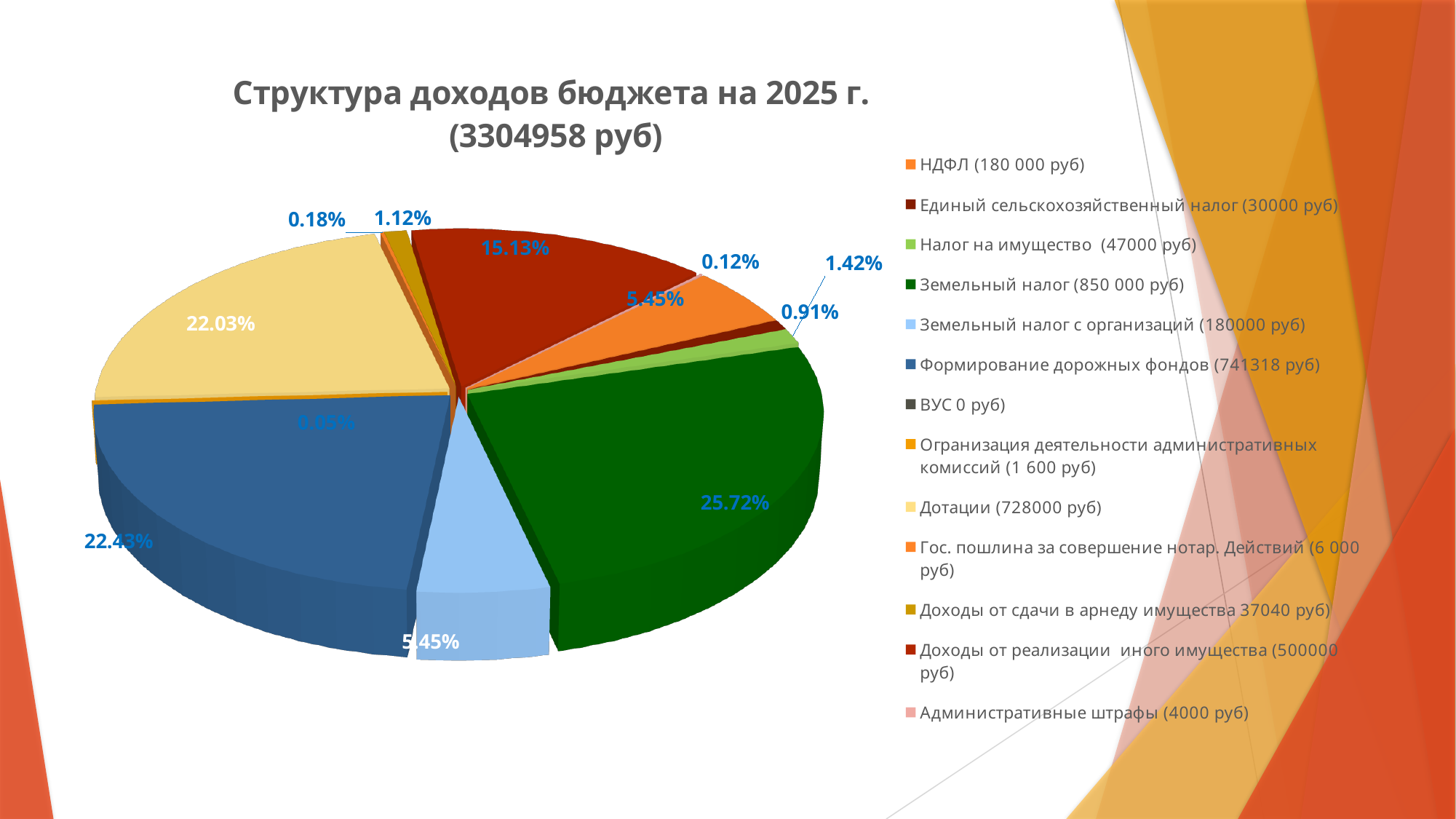
What share of the pie does Формирование дорожных фондов take? 22.43% What is the title of the chart? Структура доходов бюджета на 2025 г. (3304958 руб) What is the difference in percentage points between the Земельный налог slice (25.72%) and the Формирование дорожных фондов slice (22.43%)? 3.29 Which is larger: the share for Формирование дорожных фондов or the share for Дотации? Формирование дорожных фондов According to the legend, what amount is given for ВУС? 0 руб What share of the pie does Земельный налог take? 25.72% How many entries does the chart legend list? 13 What share of the pie does Доходы от реализации иного имущества take? 15.13% According to the legend, what amount is given for Земельный налог? 850 000 руб Which category has the largest slice of the pie? Земельный налог (850 000 руб) What kind of chart is shown on the slide? pie chart